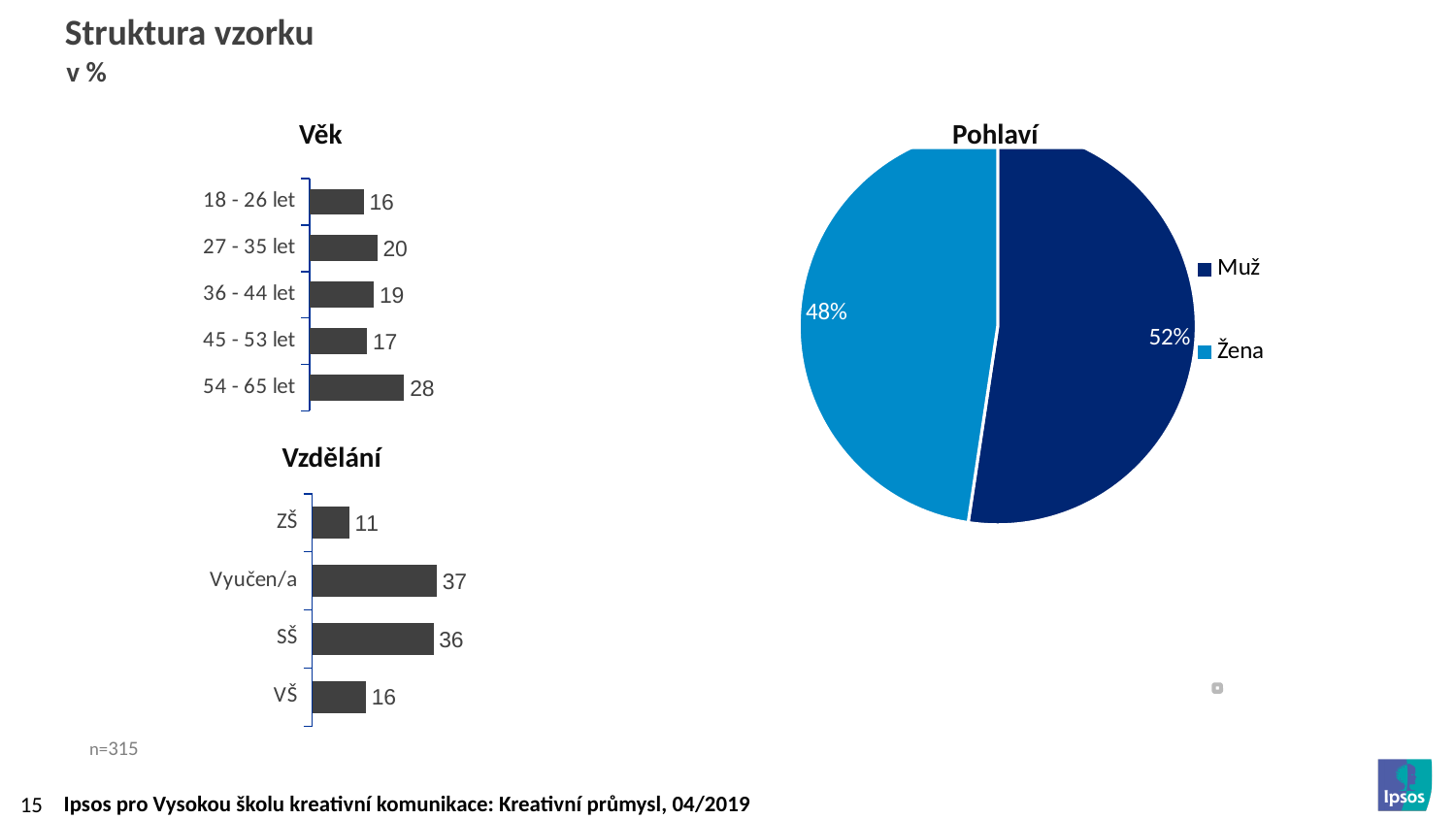
In the "Věk" chart, how many age categories are shown? 5 In the "Vzdělání" chart, what is the value for "Vyučen/a"? 37 How many entries does the legend of the "Pohlaví" chart list? 2 In the "Vzdělání" chart, what is the difference between "Vyučen/a" and "ZŠ"? 26 In the "Věk" chart, what is the difference between "54 - 65 let" and "18 - 26 let"? 12 In the "Věk" chart, what is the value for "54 - 65 let"? 28 In the "Pohlaví" chart, which slice is larger, "Muž" or "Žena"? Muž In the "Pohlaví" chart, what share is "Muž"? 52% In the "Vzdělání" chart, which category has the lowest value? ZŠ In the "Věk" chart, which age category has the lowest value? 18 - 26 let In the "Vzdělání" chart, which is larger, "SŠ" or "VŠ"? SŠ What kind of chart is the "Pohlaví" chart? Pie chart